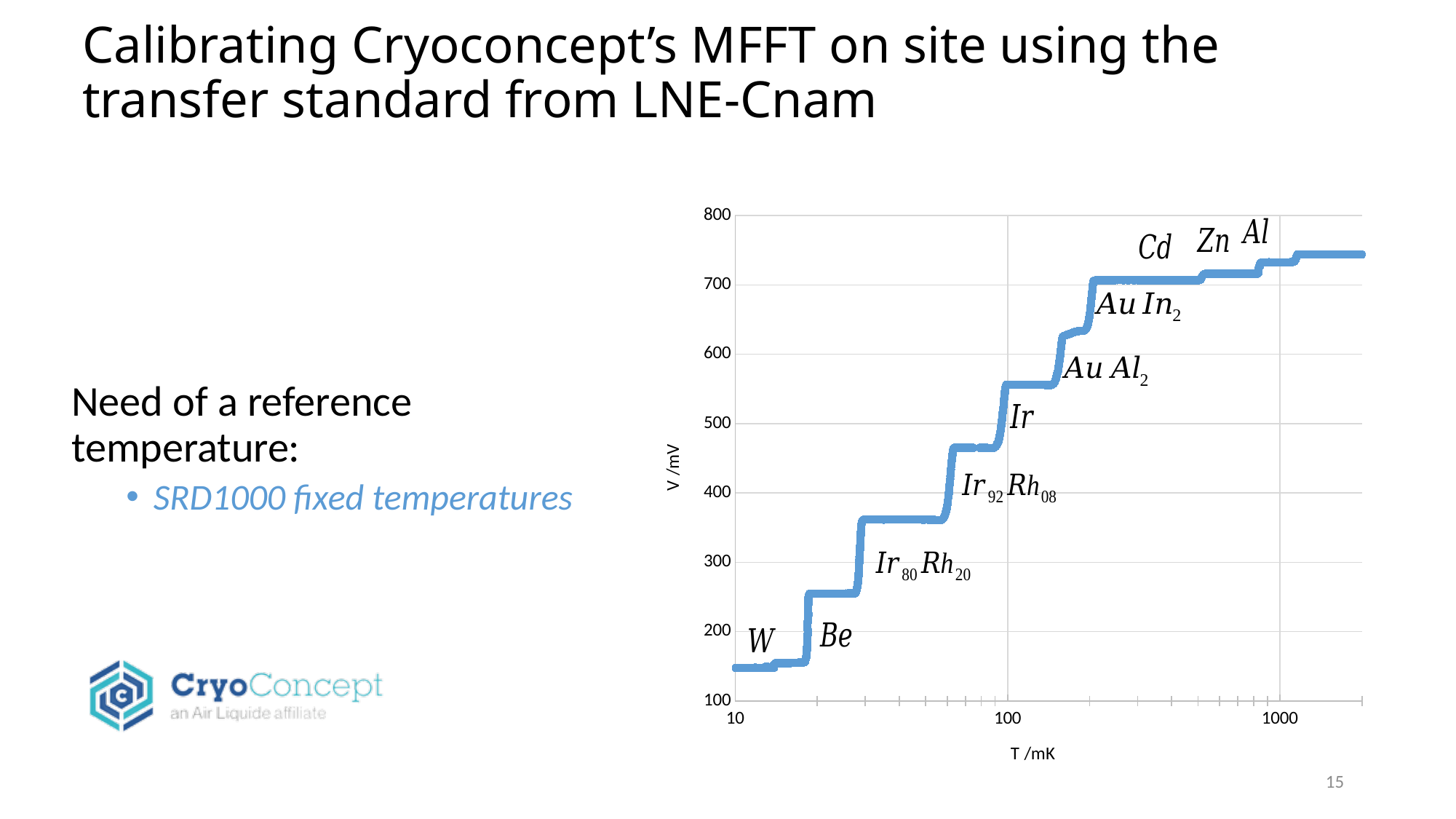
What kind of chart is shown on the slide? line chart Is the value of V at T = 50 mK greater or less than 400? less How many fixed-point materials are labelled along the curve? 10 Is the value of V at T = 10 mK greater or less than 200? less What is the label of the horizontal axis of the chart? T /mK Which labelled fixed point is reached at the lowest temperature on the curve? W Is the value of V at T = 50 mK greater or less than 300? greater What is the label of the vertical axis of the chart? V /mV Overall, does the plotted voltage rise or fall as T increases along the x axis? rise